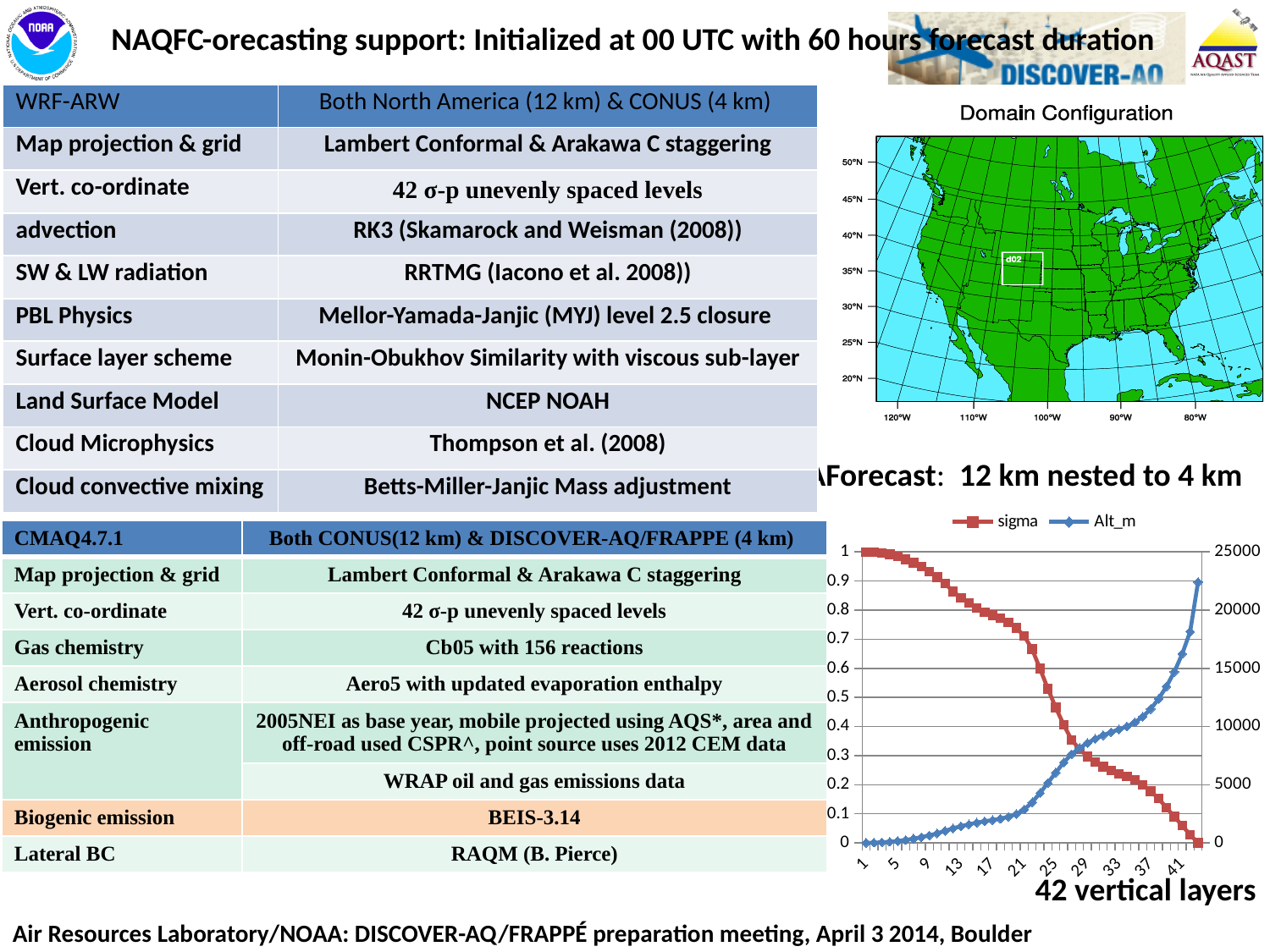
In the bottom-right chart, is the sigma value at layer 21 greater or less than 0.5? greater In the bottom-right chart, does the sigma series rise or fall as the layer number increases along the x axis? fall In the bottom-right chart, which series is drawn in red with square markers? sigma In the bottom-right chart, does the Alt_m series rise or fall as the layer number increases along the x axis? rise In the bottom-right chart, is the sigma value at layer 5 greater or less than 0.9? greater In the bottom-right chart, what is the sigma value at layer 1? 1 In the bottom-right chart, is the Alt_m value at layer 21 greater or less than 5000? less In the bottom-right chart, which is larger: the sigma value at layer 5 or the sigma value at layer 37? layer 5 What kind of chart is shown at the bottom right of the slide? line chart How many series does the legend of the chart at the bottom right list? 2 According to the caption under the bottom-right chart, how many vertical layers are plotted? 42